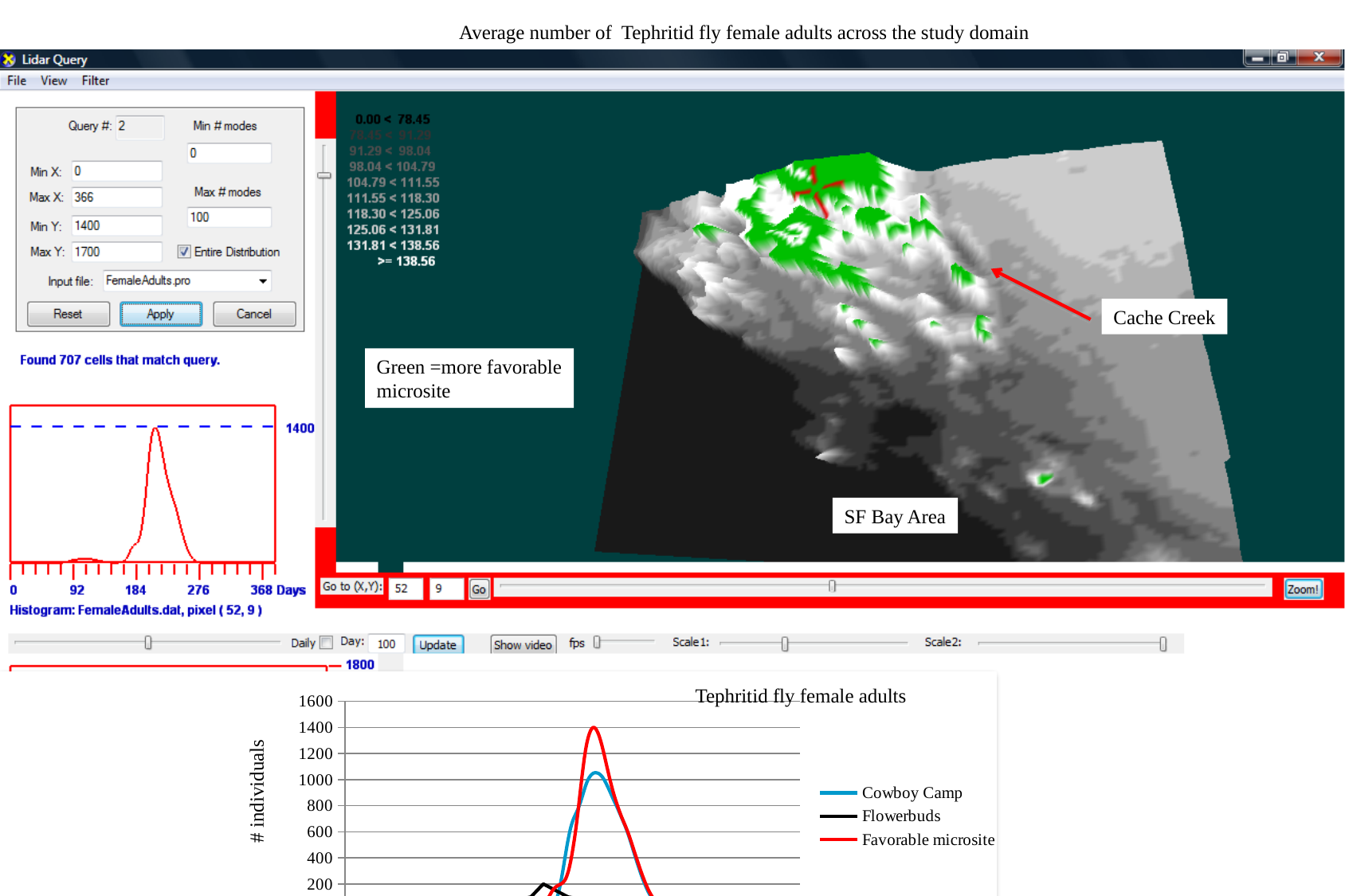
In the 'Tephritid fly female adults' chart, which series reaches the highest peak? Favorable microsite In the 'Tephritid fly female adults' chart, is the peak value of the Flowerbuds series greater or less than 400? less What colour is the Favorable microsite line in the 'Tephritid fly female adults' chart? red In the 'Tephritid fly female adults' chart, which series peaks higher, Cowboy Camp or Favorable microsite? Favorable microsite In the 'Tephritid fly female adults' chart, is the peak value of the Cowboy Camp series greater or less than 800? greater In the 'Tephritid fly female adults' chart, which series peaks higher, Flowerbuds or Cowboy Camp? Cowboy Camp In the 'Tephritid fly female adults' chart, which series has the lowest peak? Flowerbuds How many series does the legend of the 'Tephritid fly female adults' chart list? 3 What is the label of the vertical axis of the 'Tephritid fly female adults' chart? # individuals In the 'Tephritid fly female adults' chart, is the peak value of the Cowboy Camp series greater or less than 1200? less What kind of chart is the 'Tephritid fly female adults' chart at the bottom of the slide? line chart